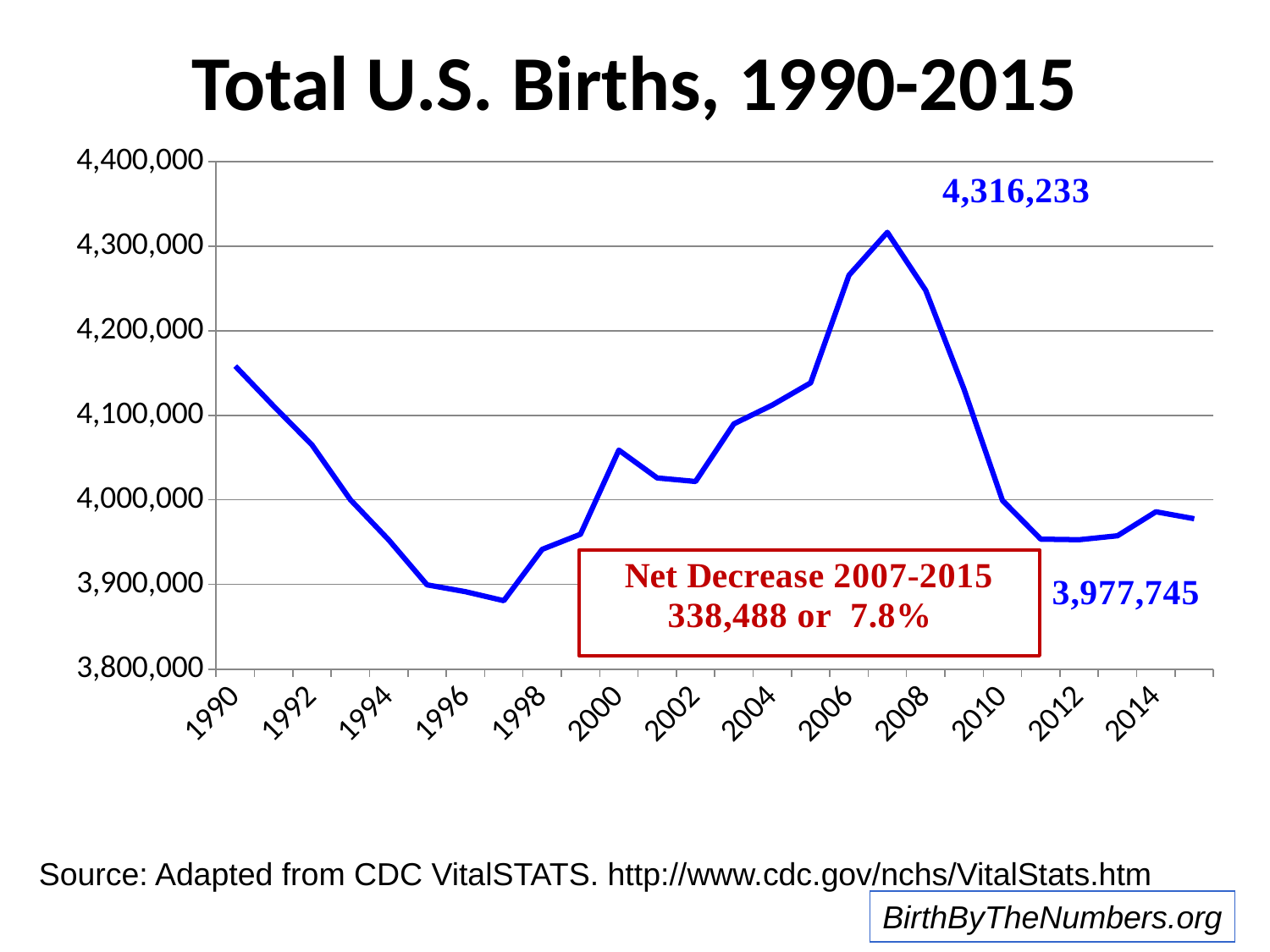
What is the labelled value of total U.S. births in 2015? 3,977,745 What is the title of the chart? Total U.S. Births, 1990-2015 Which year had more births, 1990 or 2015? 1990 What type of chart is shown on the slide? Line chart What is the highest value shown on the vertical axis? 4,400,000 In which year were total U.S. births highest? 2007 Is the value for 1990 greater or less than 4,100,000? greater What is the labelled peak value of total U.S. births in 2007? 4,316,233 What is the net decrease in births from 2007 to 2015, as stated on the slide? 338,488 In which year were total U.S. births lowest? 1997 Is the value for 2011 greater or less than 4,000,000? less Do total births rise or fall between 2007 and 2010? Fall